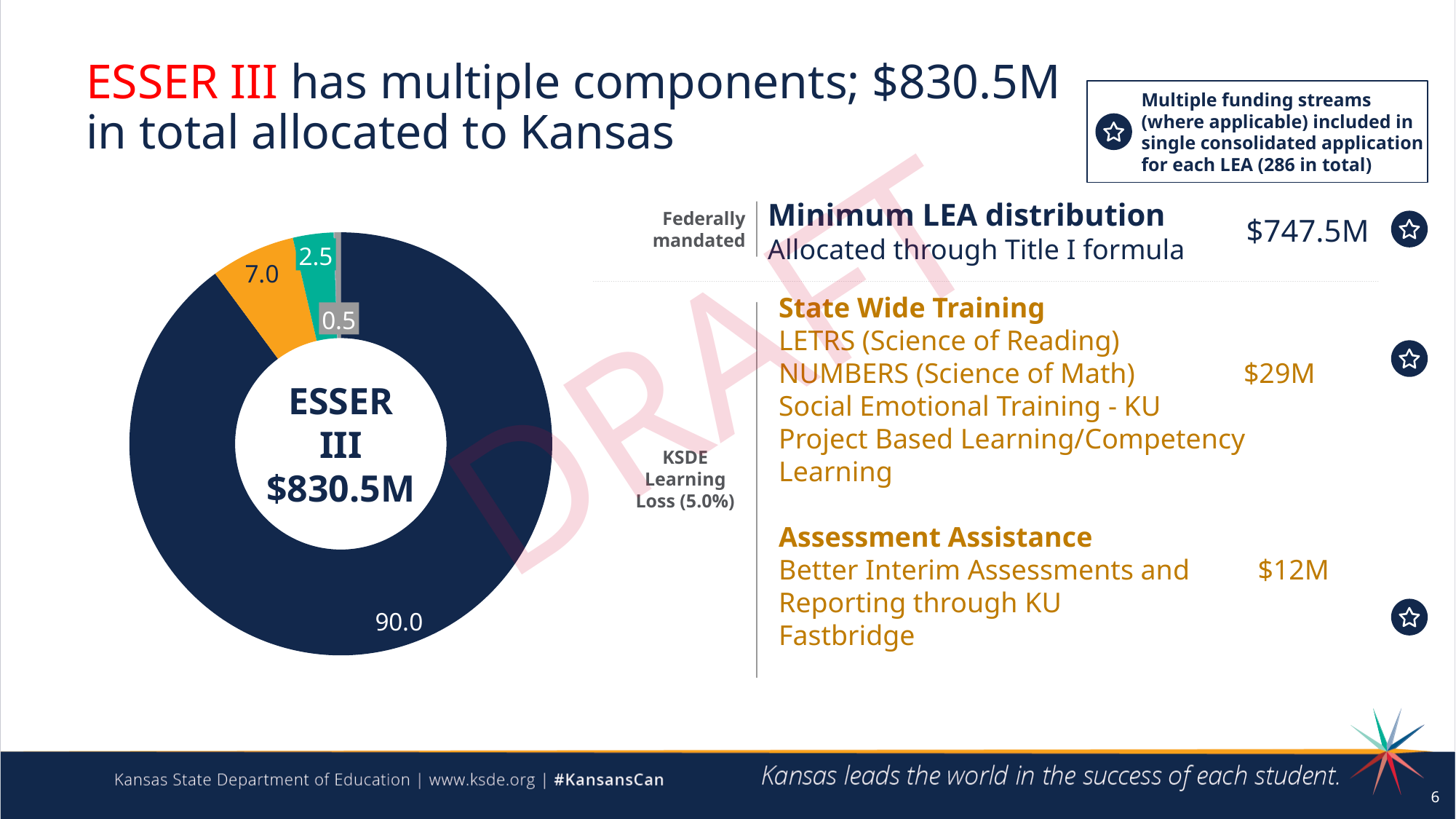
What is the value of the smallest slice in the donut chart? 0.5 What is the value of the largest slice in the donut chart? 90.0 What is the difference between the orange slice (7.0) and the teal slice (2.5)? 4.5 How many slices does the donut chart have? 4 What value is labelled on the orange slice of the donut chart? 7.0 What text is written in the centre of the donut chart? ESSER III $830.5M What is the difference between the dark navy slice (90.0) and the orange slice (7.0)? 83.0 What value is labelled on the dark navy slice of the donut chart? 90.0 Which slice is larger, the orange slice or the teal slice? orange slice What is the sum of all four slice values in the donut chart? 100.0 What kind of chart is shown on the slide? pie chart (donut) What value is labelled on the teal (green) slice of the donut chart? 2.5